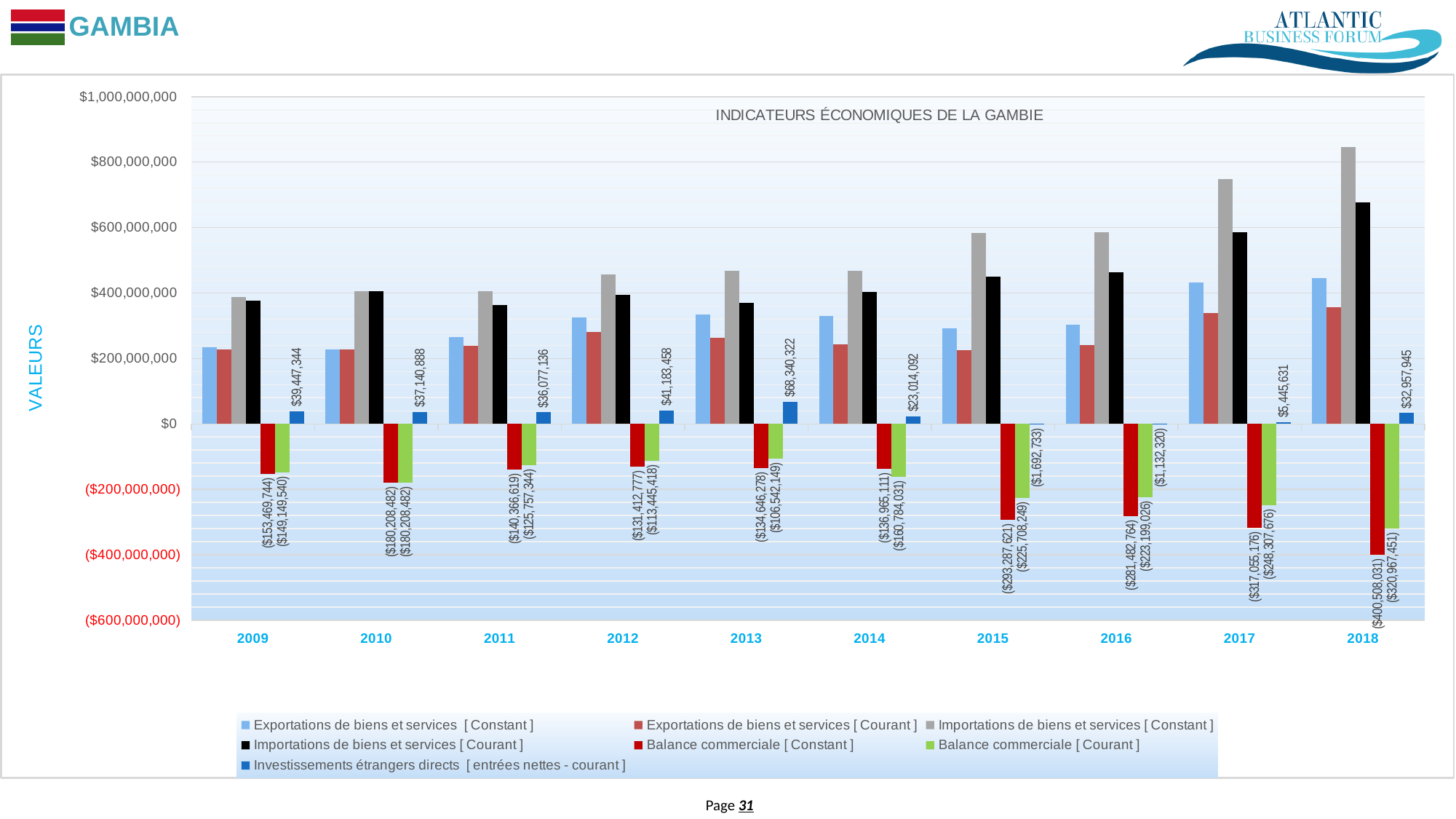
Is the value for Importations de biens et services [Constant] in 2018 greater or less than $800,000,000? greater What is the difference between Balance commerciale [Constant] and Balance commerciale [Courant] in 2018? $79,540,580 How many series does the legend list? 7 How many years are shown on the x axis? 10 In which year is Balance commerciale [Constant] the lowest (most negative)? 2018 Do the values for Importations de biens et services [Constant] generally rise or fall from 2009 to 2018? rise Which year has the larger value for Investissements étrangers directs [entrées nettes - courant], 2009 or 2010? 2009 What is the value of Investissements étrangers directs [entrées nettes - courant] in 2015? ($1,692,733) What is the value of Balance commerciale [Constant] in 2018? ($400,508,031) What is the value of Investissements étrangers directs [entrées nettes - courant] in 2013? $68,340,322 In which year is Investissements étrangers directs [entrées nettes - courant] the highest? 2013 What kind of chart is shown on the slide? bar chart